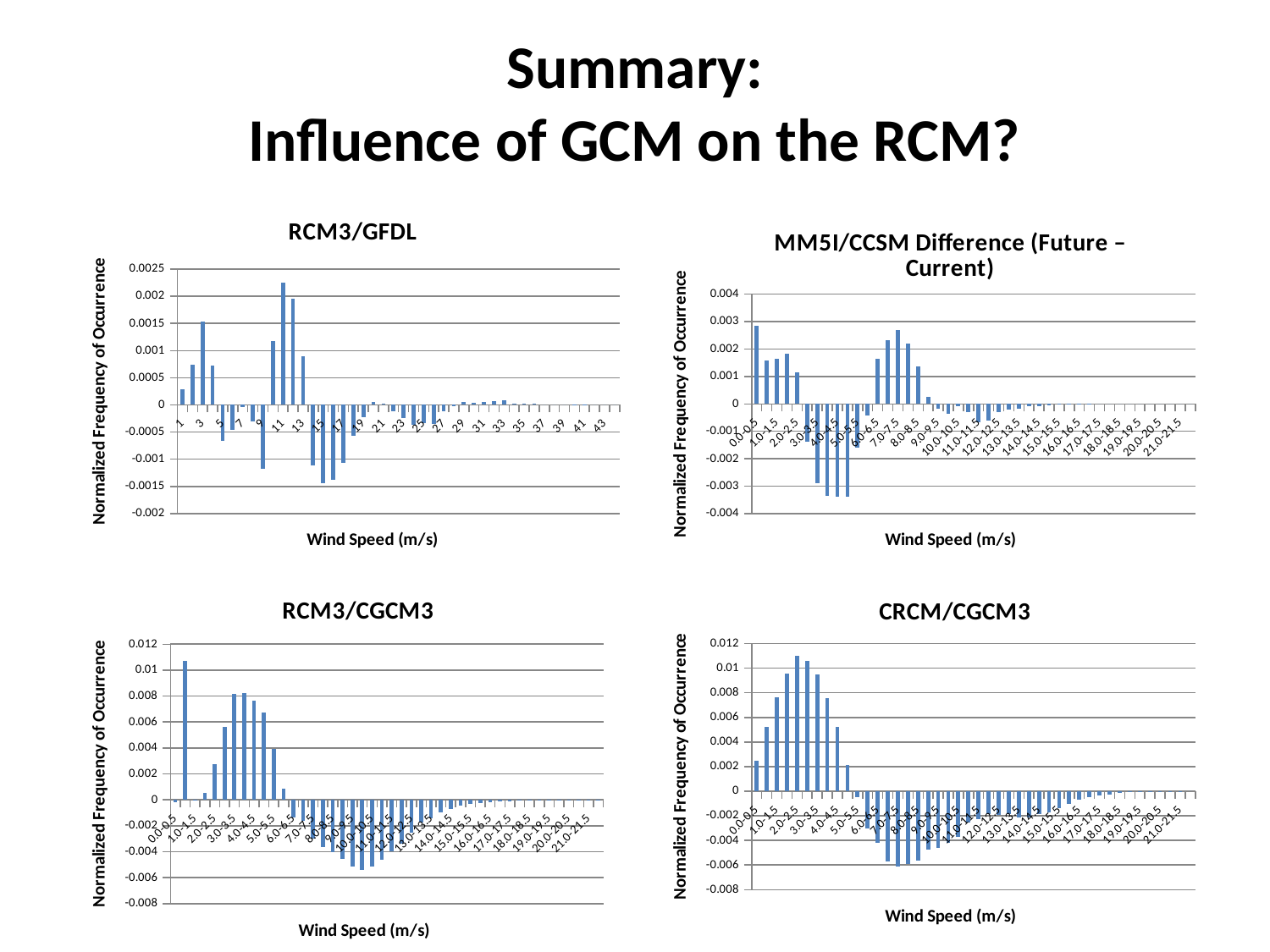
What is the x-axis title of the CRCM/CGCM3 chart? Wind Speed (m/s) In the MM5I/CCSM Difference (Future – Current) chart, is the value for 7.0-7.5 greater or less than 0.002? greater What is the y-axis title of the RCM3/CGCM3 chart? Normalized Frequency of Occurrence In the RCM3/CGCM3 chart, which wind speed category has the highest value? 0.5-1.0 In the RCM3/CGCM3 chart, is the value for 1.0-1.5 greater or less than 0.01? less In the RCM3/GFDL chart, which wind speed category has the highest value? 11 In the RCM3/CGCM3 chart, which is larger, the value for 1.0-1.5 or the value for 3.0-3.5? 3.0-3.5 What kind of chart is the RCM3/GFDL chart? bar chart In the CRCM/CGCM3 chart, is the value for 2.5-3.0 greater or less than 0.01? greater In the CRCM/CGCM3 chart, do the values rise or fall from 2.5-3.0 to 5.0-5.5? fall